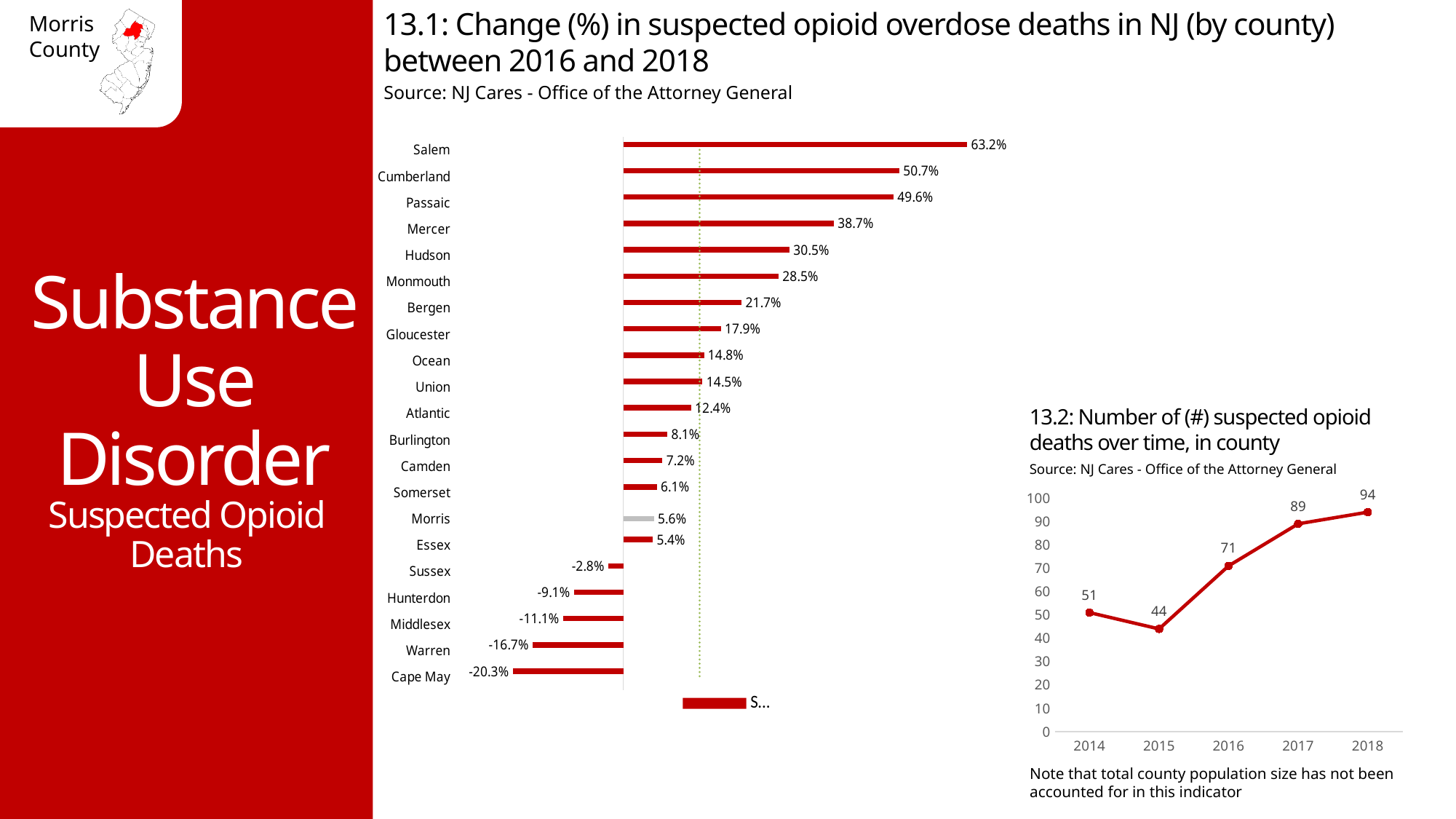
In chart 13.1 (change in suspected opioid overdose deaths by county), what is the value for Morris? 5.6% In chart 13.2 (number of suspected opioid deaths over time), what is the difference between the values for 2018 and 2014? 43 What kind of chart is chart 13.2 (number of suspected opioid deaths over time)? Line chart In chart 13.1 (change in suspected opioid overdose deaths by county), what is the difference between the values for Salem and Cumberland? 12.5% In chart 13.1 (change in suspected opioid overdose deaths by county), which is larger, the value for Hudson or the value for Monmouth? Hudson What kind of chart is chart 13.1 (change in suspected opioid overdose deaths by county)? Bar chart In chart 13.1 (change in suspected opioid overdose deaths by county), which county has the lowest value? Cape May In chart 13.2 (number of suspected opioid deaths over time), which year has the lowest value? 2015 In chart 13.1 (change in suspected opioid overdose deaths by county), which county has the highest value? Salem In chart 13.1 (change in suspected opioid overdose deaths by county), what is the value for Passaic? 49.6% In chart 13.2 (number of suspected opioid deaths over time), what is the value for 2016? 71 In chart 13.1 (change in suspected opioid overdose deaths by county), how many counties are shown? 21